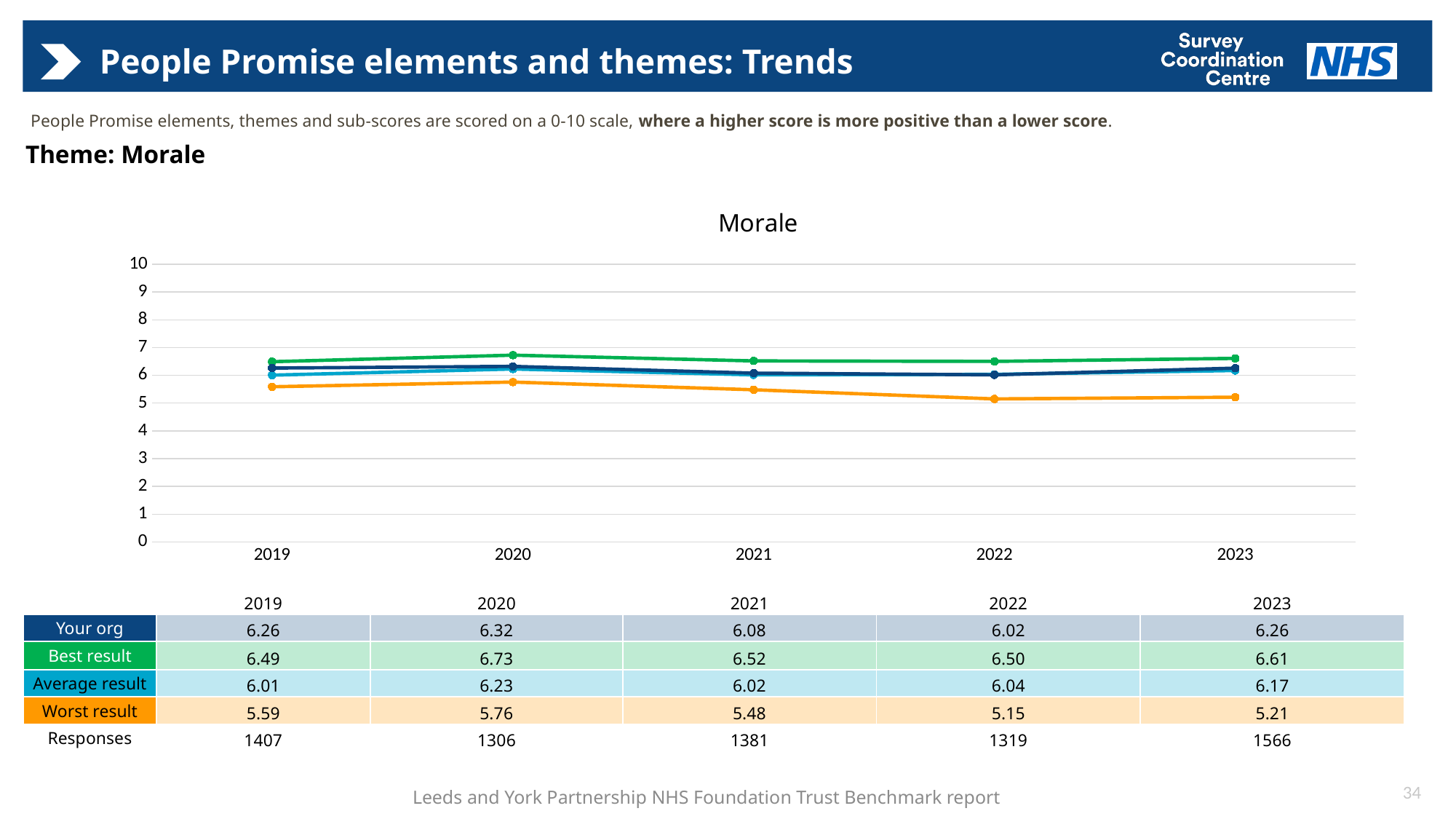
What is the Your org score for 2021? 6.08 What is the title of the chart? Morale What is the Best result score for 2020? 6.73 In which year is the Best result score highest? 2020 How many series are plotted on the chart? 4 What is the Average result score for 2023? 6.17 How many years are plotted on the x axis? 5 Which is larger in 2022, the Your org score or the Average result score? Average result What is the difference between the Best result and Your org scores in 2023? 0.35 In which year is the Worst result score lowest? 2022 What is the Worst result score for 2022? 5.15 What kind of chart is shown on the slide? line chart